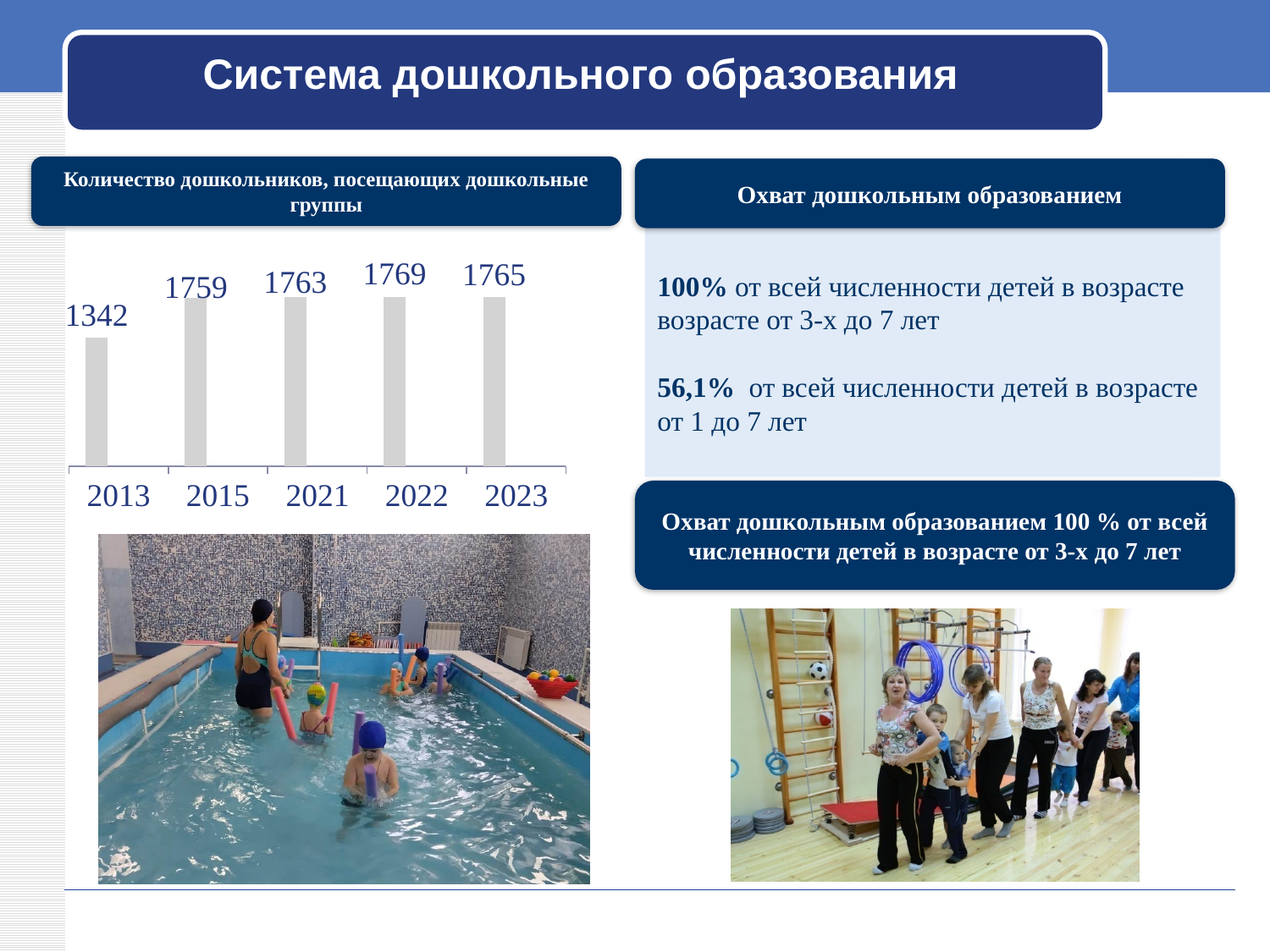
Which year has the lowest value in the chart of the number of preschoolers attending preschool groups? 2013 What is the value for 2023 in the chart of the number of preschoolers attending preschool groups? 1765 Does the value in the chart of the number of preschoolers attending preschool groups rise or fall from 2013 to 2022? Rise What is the value for 2021 in the chart of the number of preschoolers attending preschool groups? 1763 What is the title of the chart on the left side of the slide? Количество дошкольников, посещающих дошкольные группы In the chart of the number of preschoolers attending preschool groups, which is larger: the value for 2015 or the value for 2021? 2021 What is the difference between the values for 2015 and 2013 in the chart of the number of preschoolers attending preschool groups? 417 Which year has the highest value in the chart of the number of preschoolers attending preschool groups? 2022 What kind of chart is used to show the number of preschoolers attending preschool groups? Bar chart How many years are shown on the x axis of the chart of the number of preschoolers attending preschool groups? 5 What is the difference between the values for 2022 and 2023 in the chart of the number of preschoolers attending preschool groups? 4 What is the value for 2013 in the chart of the number of preschoolers attending preschool groups? 1342